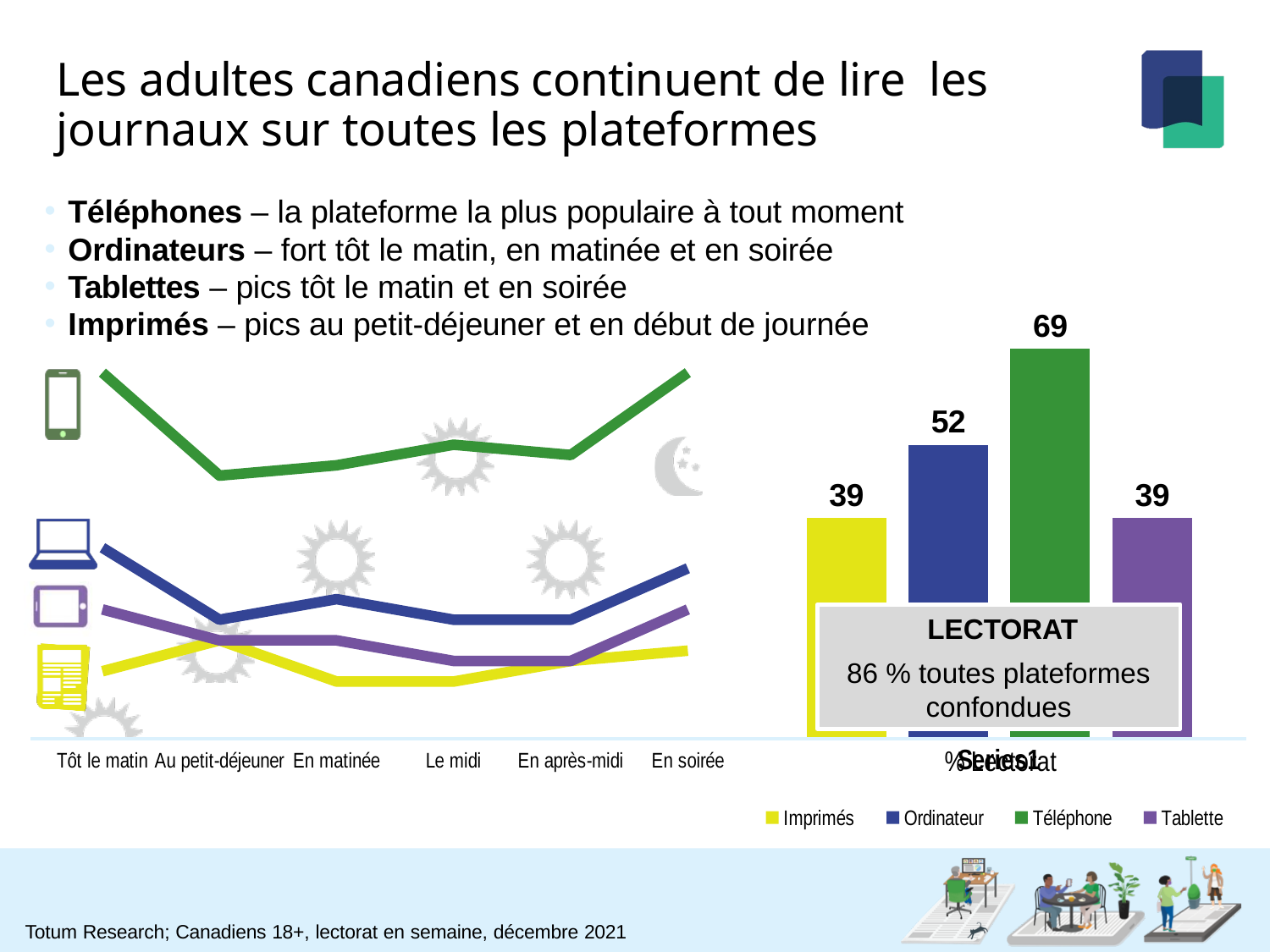
In the line chart on the left, does the green (Téléphone) line rise or fall from Tôt le matin to Au petit-déjeuner? fall In the bar chart on the right, which is larger, the value for Ordinateur or the value for Imprimés? Ordinateur What kind of chart is the chart on the right? bar chart How many series does the legend at the bottom right list? 4 In the bar chart on the right, what is the value for Imprimés? 39 What kind of chart is the chart on the left? line chart In the bar chart on the right, what is the difference between the values for Ordinateur and Tablette? 13 In the bar chart on the right, what is the value for Ordinateur? 52 In the bar chart on the right, which platform has the highest value? Téléphone In the bar chart on the right, what is the difference between the values for Téléphone and Ordinateur? 17 In the bar chart on the right, what is the value for Téléphone? 69 How many time-of-day categories are shown on the x axis of the line chart on the left? 6